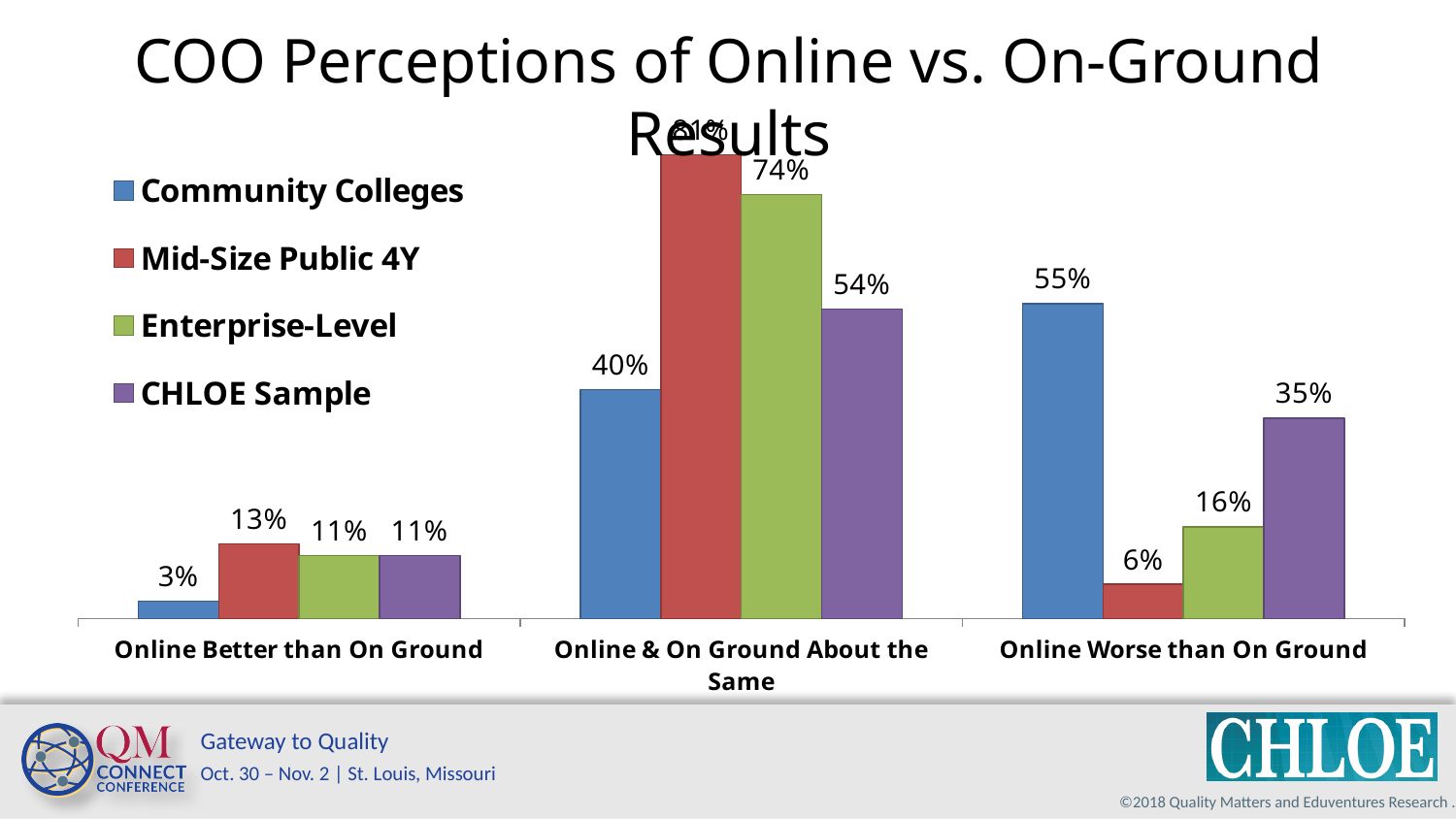
What is the value for Community Colleges in the Online Better than On Ground category? 3% What is the value for Mid-Size Public 4Y in the Online Worse than On Ground category? 6% Which series has the highest value in the Online Worse than On Ground category? Community Colleges In the Online Worse than On Ground category, what is the difference between the Community Colleges value and the CHLOE Sample value? 20 percentage points What kind of chart is shown on the slide? Bar chart Which series has the lowest value in the Online Better than On Ground category? Community Colleges How many series does the legend list? 4 In the Online Worse than On Ground category, which is larger: Enterprise-Level or CHLOE Sample? CHLOE Sample How many categories are shown on the x axis of the chart? 3 What is the value for CHLOE Sample in the Online Worse than On Ground category? 35% In the Online & On Ground About the Same category, what is the difference between the Enterprise-Level value and the CHLOE Sample value? 20 percentage points What is the value for Enterprise-Level in the Online & On Ground About the Same category? 74%